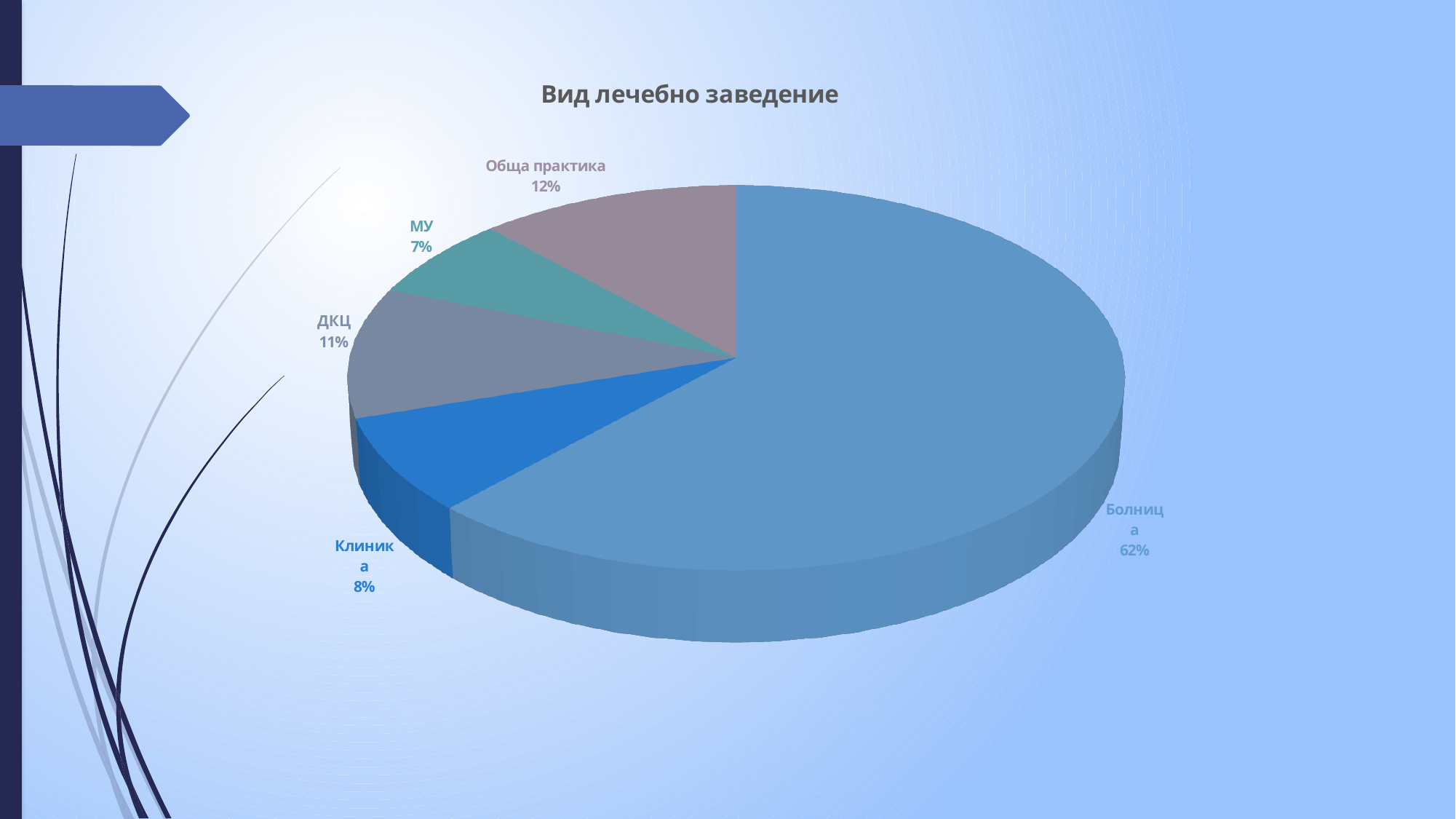
What percentage is shown for Обща практика? 12% How many slices does the pie chart have? 5 What is the title of the chart? Вид лечебно заведение Which category has the smallest share of the pie? МУ Which category has the largest share of the pie? Болница What percentage is shown for ДКЦ? 11% Which is larger, the share for ДКЦ or the share for Клиника? ДКЦ What percentage is shown for МУ? 7% What percentage is shown for Клиника? 8% What type of chart is shown on the slide? pie chart What is the difference in percentage points between Болница and Обща практика? 50 What share of the pie does Болница have? 62%